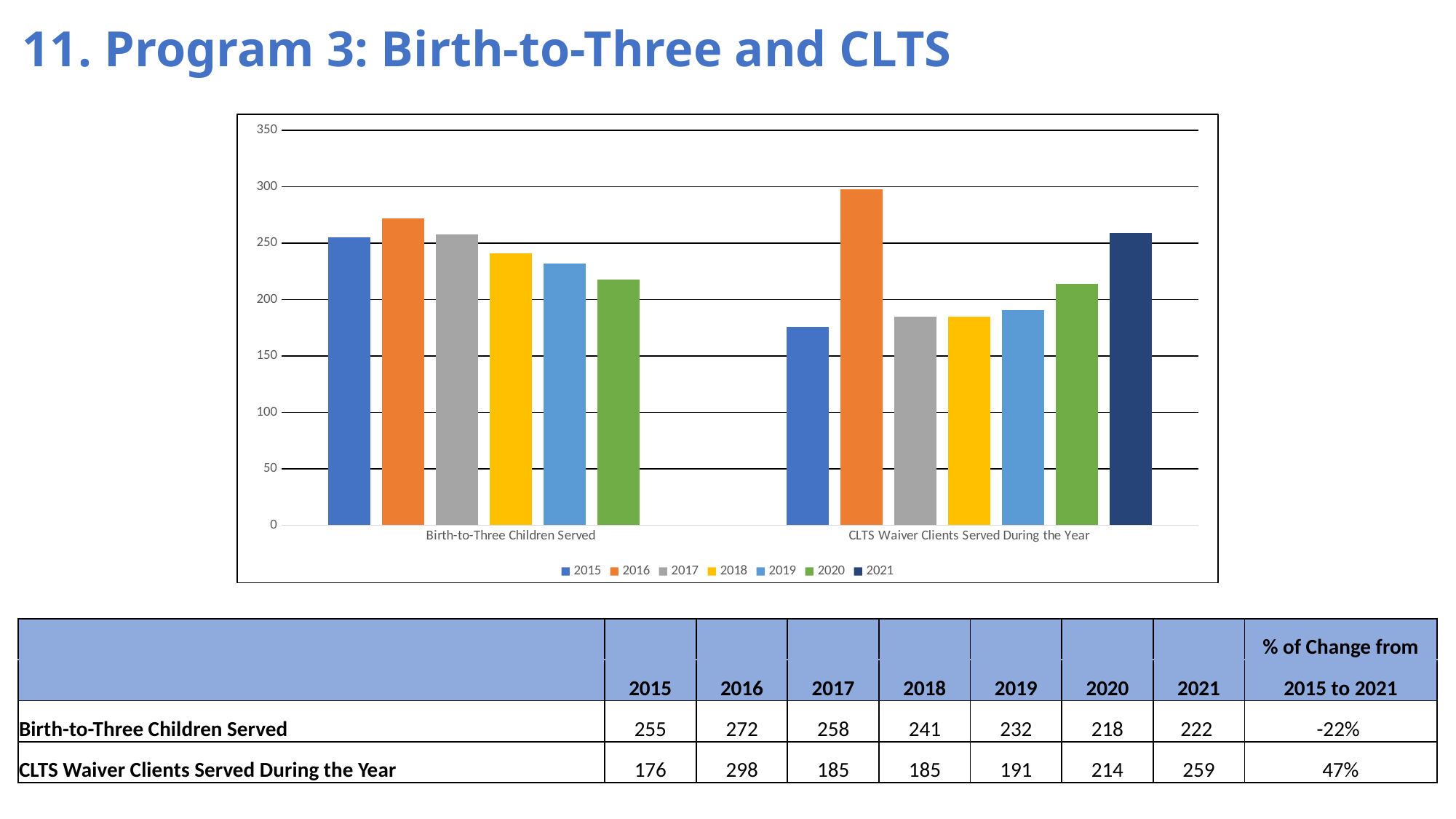
What colour is the bar for 2016 in the chart? orange Which is larger: Birth-to-Three Children Served in 2015 or CLTS Waiver Clients Served During the Year in 2015? Birth-to-Three Children Served Is the 2021 value for CLTS Waiver Clients Served During the Year greater or less than 250? greater What is the value for CLTS Waiver Clients Served During the Year in 2016? 298 Which year has the lowest value for Birth-to-Three Children Served among the plotted bars? 2020 From 2016 to 2020, do the values for Birth-to-Three Children Served rise or fall? fall How many bars are plotted for the Birth-to-Three Children Served category? 6 How many series does the chart legend list? 7 What kind of chart is shown on the slide? bar chart Which year has the highest value for CLTS Waiver Clients Served During the Year? 2016 What is the value for Birth-to-Three Children Served in 2019? 232 What is the difference between the 2016 and 2015 values for CLTS Waiver Clients Served During the Year? 122